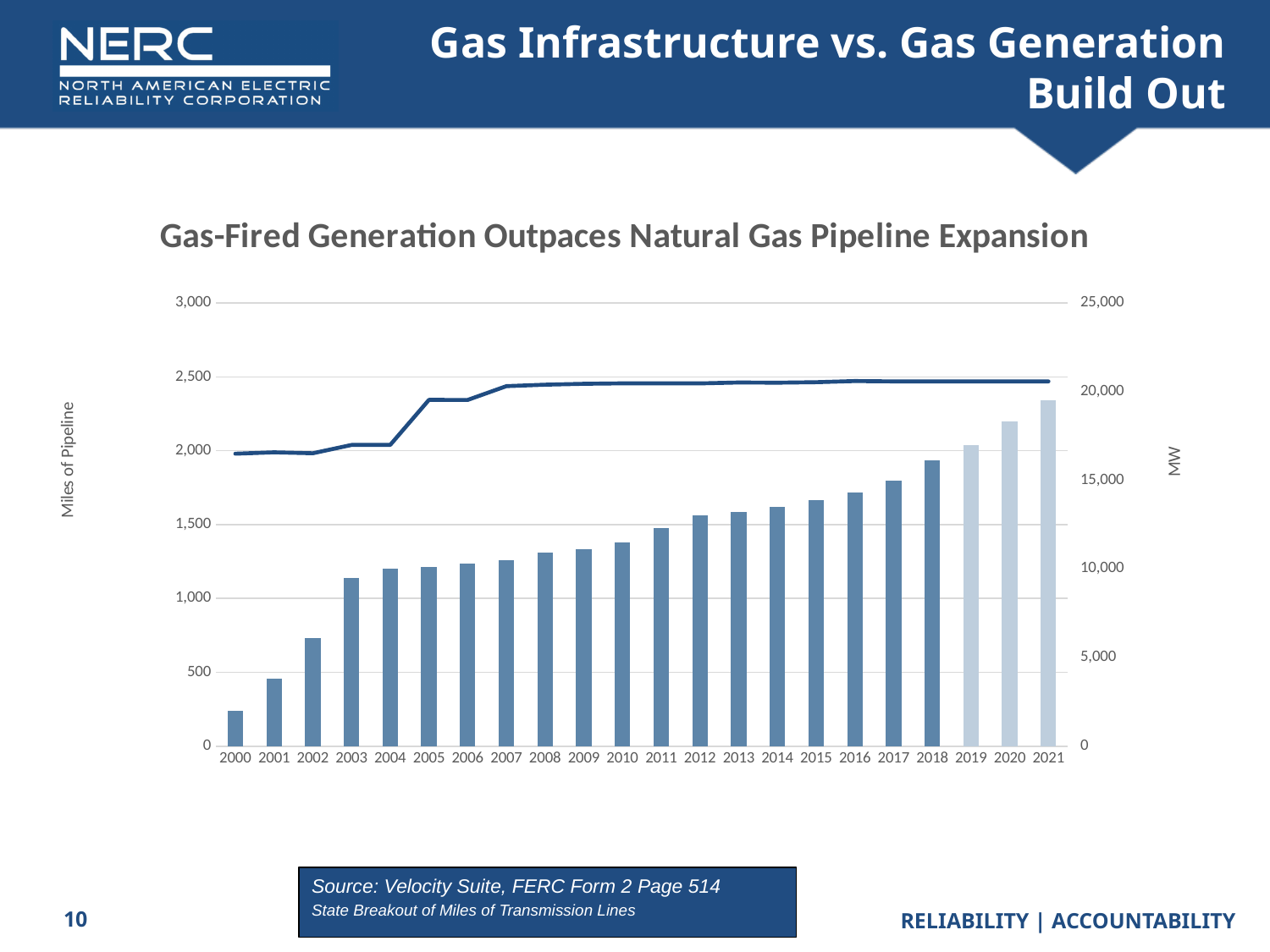
Which year has a taller bar, 2015 or 2010? 2015 Do the bar values rise or fall from 2000 to 2021? Rise Is the bar value for 2021 greater or less than 15,000 MW? greater Which year has the tallest bar in the chart? 2021 Is the bar value for 2000 greater or less than 5,000 MW? less What kind of chart is shown on the slide? A combination bar and line chart What is the label on the left vertical axis of the chart? Miles of Pipeline Is the line value for 2010 greater or less than 2,000 miles of pipeline? greater What is the title of the chart? Gas-Fired Generation Outpaces Natural Gas Pipeline Expansion Which year has the shortest bar in the chart? 2000 How many years are shown along the x axis of the chart? 22